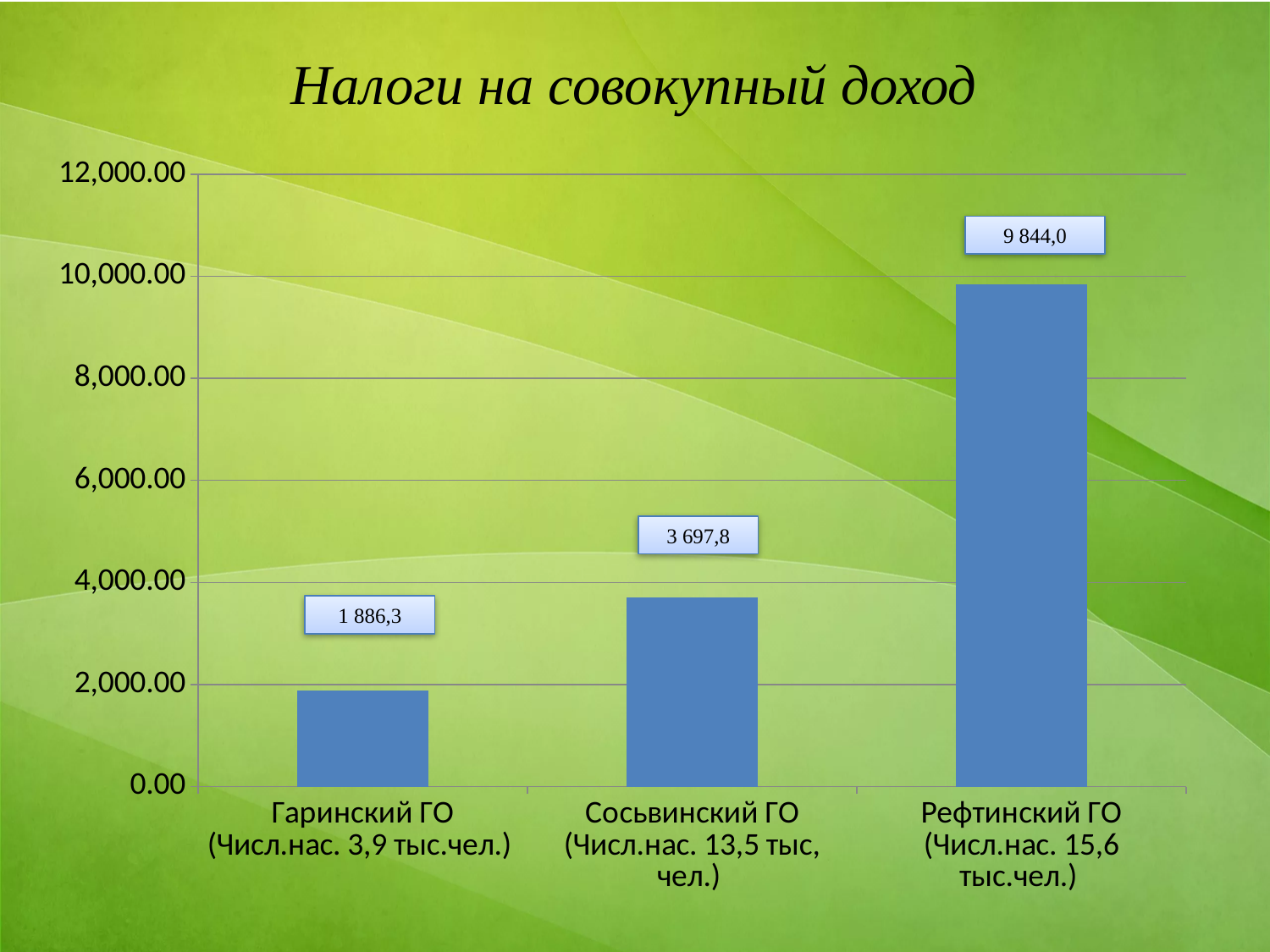
Is the value for Рефтинский ГО greater or less than 8,000.00? greater What is the value for Гаринский ГО? 1 886,3 Which category has the lowest value? Гаринский ГО How many categories are shown in the chart? 3 Which category has the highest value? Рефтинский ГО What kind of chart is shown on the slide? bar chart What is the difference between the values for Сосьвинский ГО and Гаринский ГО? 1 811,5 What is the title of the chart? Налоги на совокупный доход What is the value for Рефтинский ГО? 9 844,0 What is the difference between the values for Рефтинский ГО and Гаринский ГО? 7 957,7 What is the value for Сосьвинский ГО? 3 697,8 Which is larger, the value for Сосьвинский ГО or the value for Гаринский ГО? Сосьвинский ГО